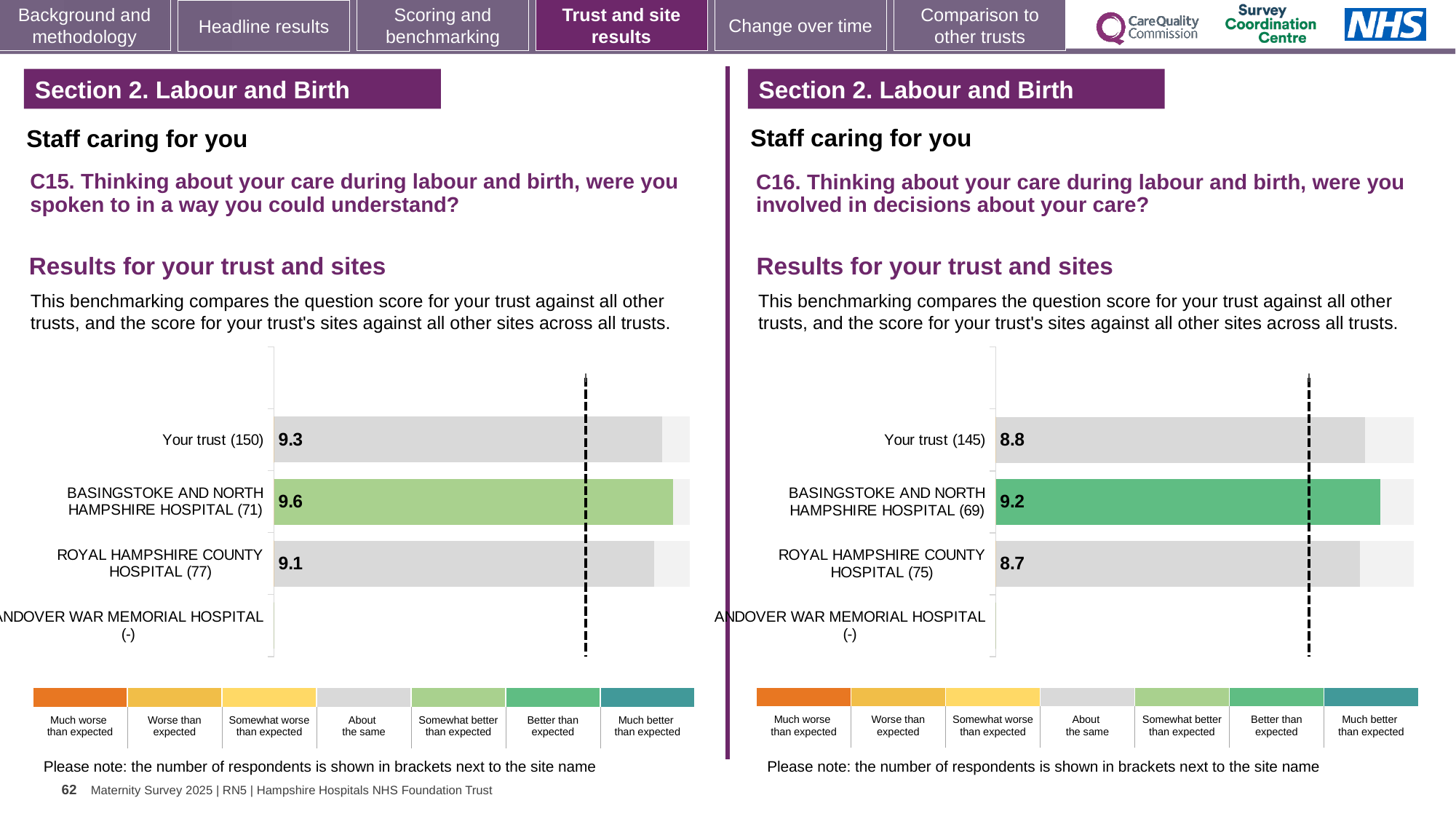
On the C16 chart (right), what is the score for BASINGSTOKE AND NORTH HAMPSHIRE HOSPITAL (69)? 9.2 On the C16 chart (right), which of the labelled scores is the lowest? ROYAL HAMPSHIRE COUNTY HOSPITAL (75) On the C15 chart (left), what is the score for ROYAL HAMPSHIRE COUNTY HOSPITAL (77)? 9.1 What kind of chart is used on the C15 chart (left)? bar chart On the C15 chart (left), what is the difference between the scores for BASINGSTOKE AND NORTH HAMPSHIRE HOSPITAL and ROYAL HAMPSHIRE COUNTY HOSPITAL? 0.5 On the C16 chart (right), what is the score for ROYAL HAMPSHIRE COUNTY HOSPITAL (75)? 8.7 On the C16 chart (right), what is the score for Your trust (145)? 8.8 On the C16 chart (right), is the score for Your trust larger or smaller than the score for BASINGSTOKE AND NORTH HAMPSHIRE HOSPITAL? smaller On the C16 chart (right), which site is shown with a green bar? BASINGSTOKE AND NORTH HAMPSHIRE HOSPITAL (69) On the C15 chart (left), what is the score for Your trust (150)? 9.3 On the C15 chart (left), what is the score for BASINGSTOKE AND NORTH HAMPSHIRE HOSPITAL (71)? 9.6 On the C15 chart (left), which site has the highest score? BASINGSTOKE AND NORTH HAMPSHIRE HOSPITAL (71)